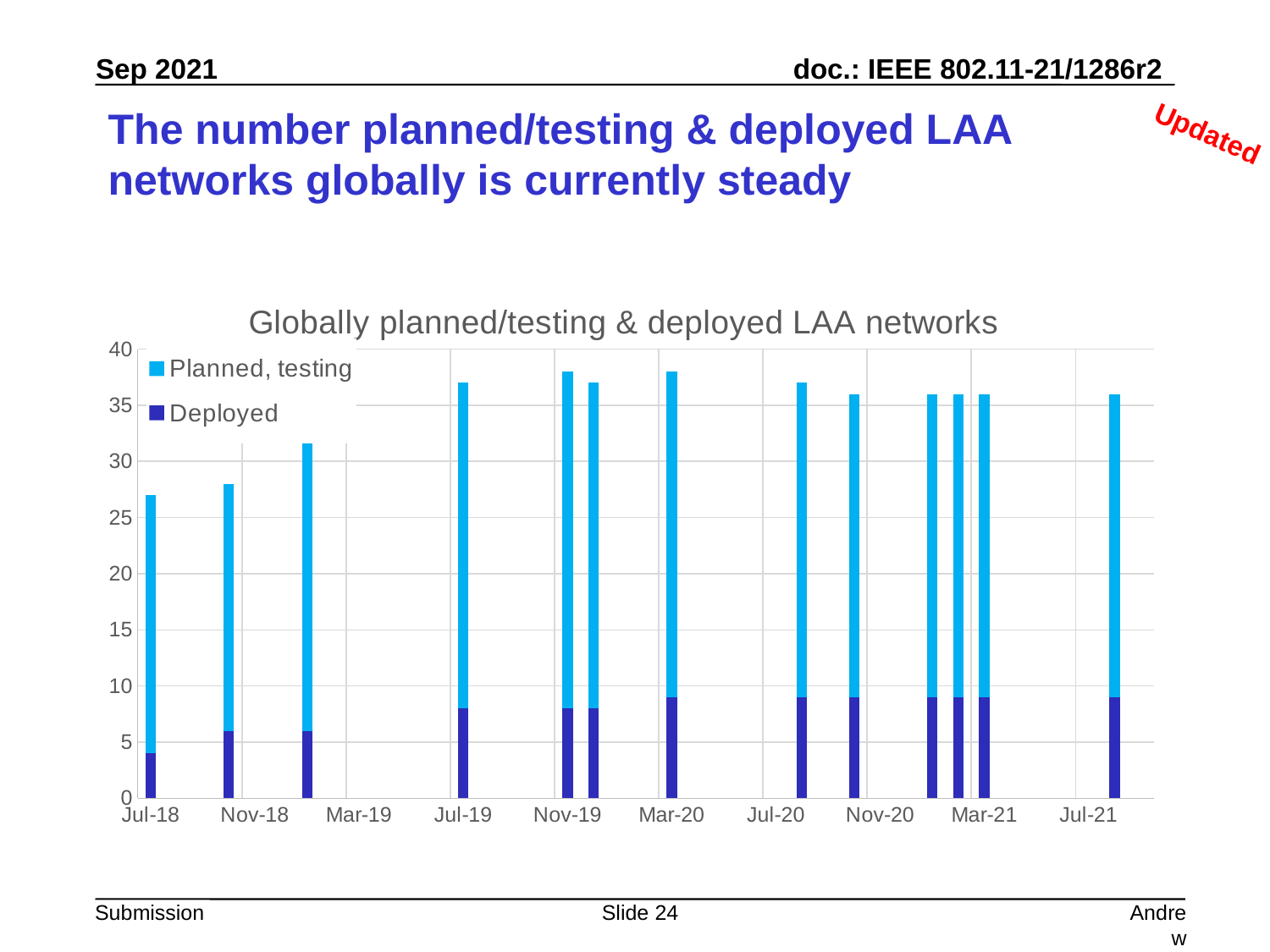
What is the title of the chart? Globally planned/testing & deployed LAA networks Which bar is taller in total, Jul-18 or Jul-19? Jul-19 What kind of chart is shown on the slide? Stacked bar chart Do the total bar heights rise or fall from Jul-18 to Jul-19? rise Is the total height of the Mar-20 bar greater or less than 35? greater Which series is shown in dark blue in the chart? Deployed Is the total height of the Nov-18 bar greater or less than 30? less Is the Deployed value for Jul-19 greater or less than 10? less How many series does the chart legend list? 2